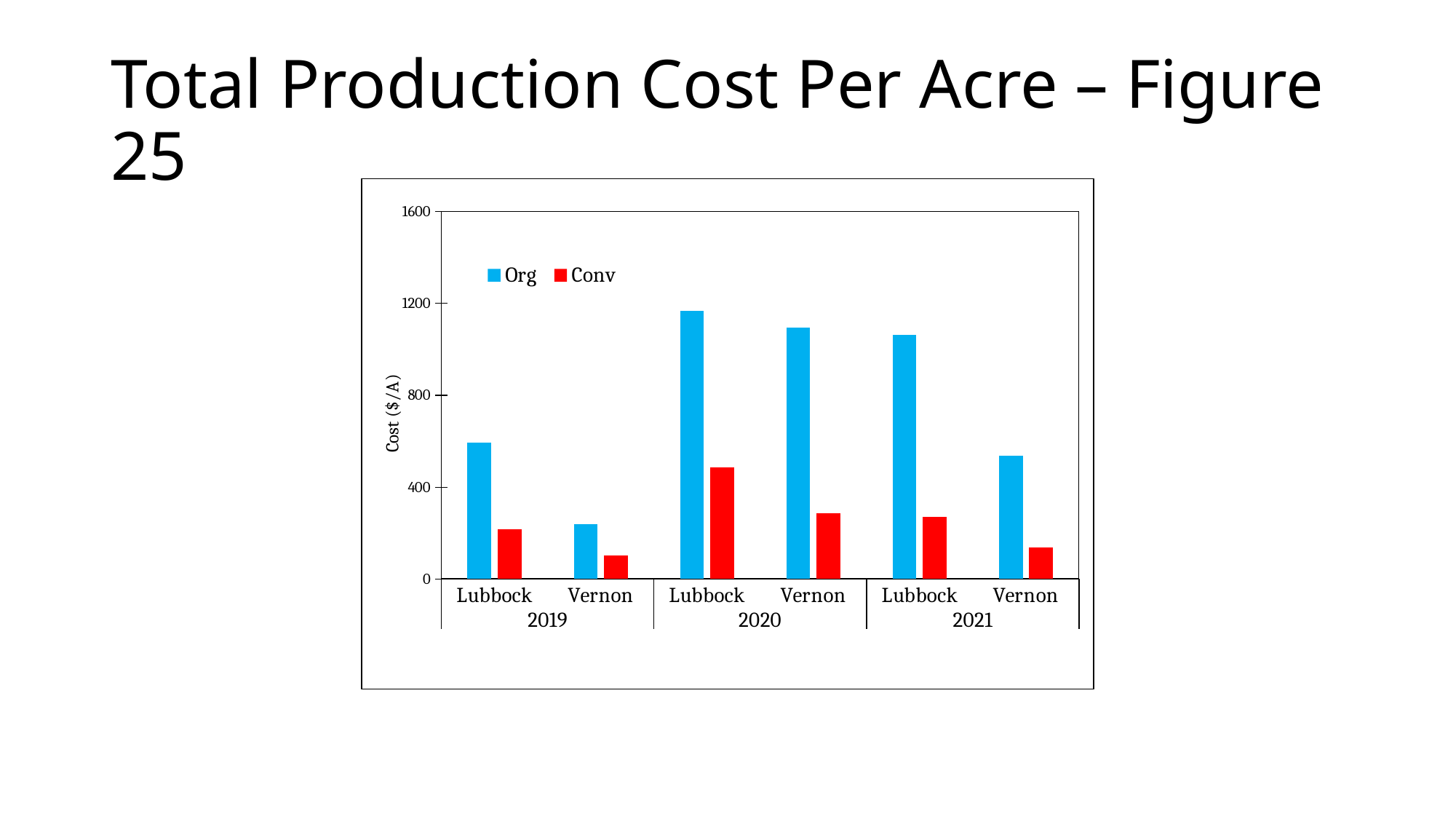
Which location and year has the lowest Conv cost? Vernon 2019 How many series does the legend list? 2 For Lubbock 2021, which is larger, the Org cost or the Conv cost? Org What kind of chart is shown on the slide? bar chart Which location and year has the lowest Org cost? Vernon 2019 Is the Org value for Vernon 2019 greater or less than 400? less How many location-year categories are plotted along the x axis? 6 Is the Org value for Lubbock 2020 greater or less than 800? greater What is the label on the vertical axis? Cost ($/A) Which location and year has the highest Org cost? Lubbock 2020 Is the Conv value for Lubbock 2020 greater or less than 400? greater Which location and year has the highest Conv cost? Lubbock 2020